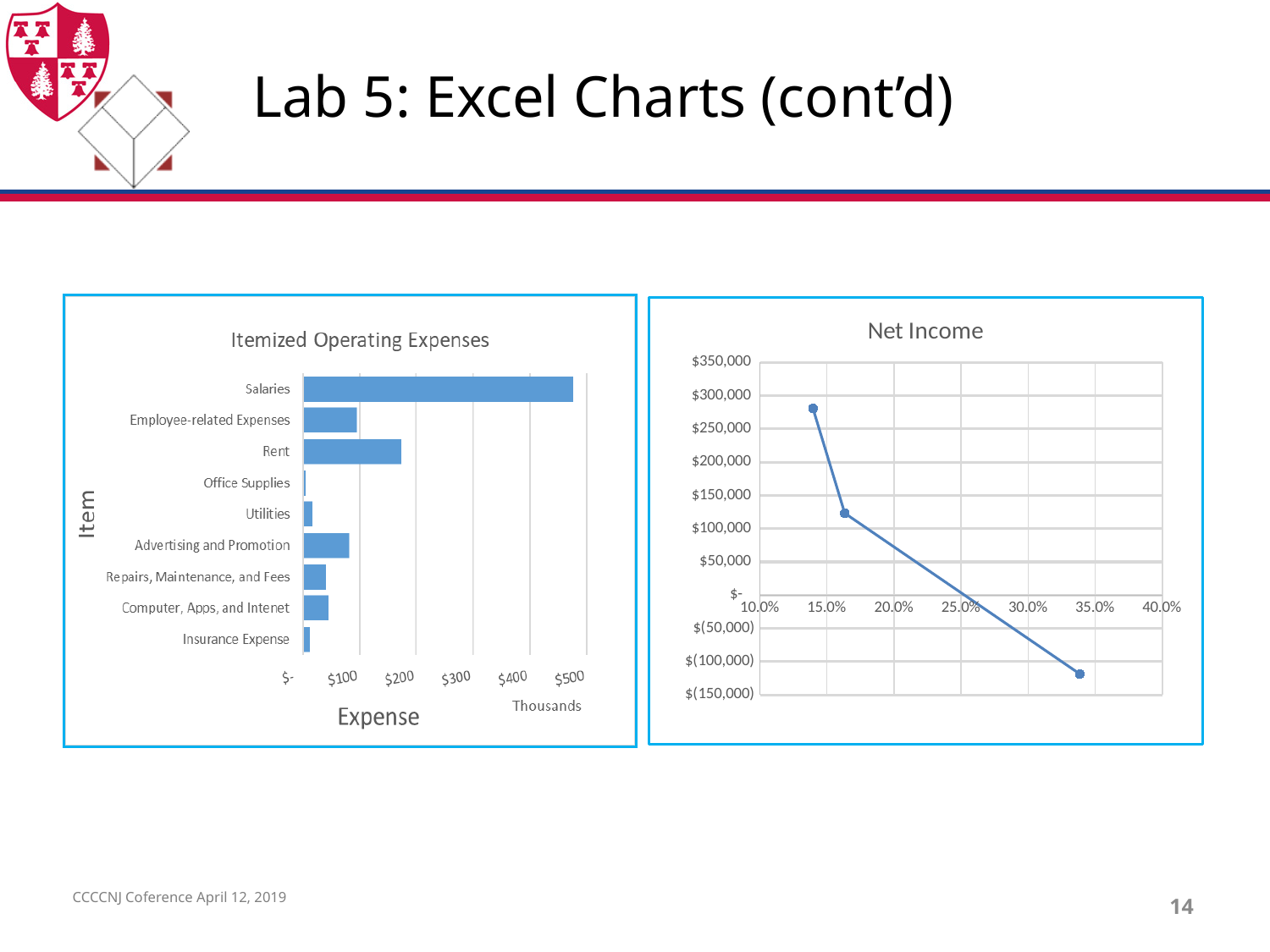
In the Itemized Operating Expenses chart, which item has the lowest expense? Office Supplies How many data points are plotted in the Net Income chart? 3 In the Itemized Operating Expenses chart, is the value for Rent greater or less than $200 thousand? less What kind of chart is the Itemized Operating Expenses chart? bar chart In the Itemized Operating Expenses chart, which is larger: Advertising and Promotion or Utilities? Advertising and Promotion In the Net Income chart, is the value of the first point (near 14%) greater or less than $250,000? greater In the Itemized Operating Expenses chart, which is larger: Rent or Employee-related Expenses? Rent What is the x-axis title of the Itemized Operating Expenses chart? Expense In the Itemized Operating Expenses chart, which item has the highest expense? Salaries In the Itemized Operating Expenses chart, is the value for Salaries greater or less than $400 thousand? greater How many items are listed in the Itemized Operating Expenses chart? 9 In the Net Income chart, do the values rise or fall as the percentage on the x axis increases? fall